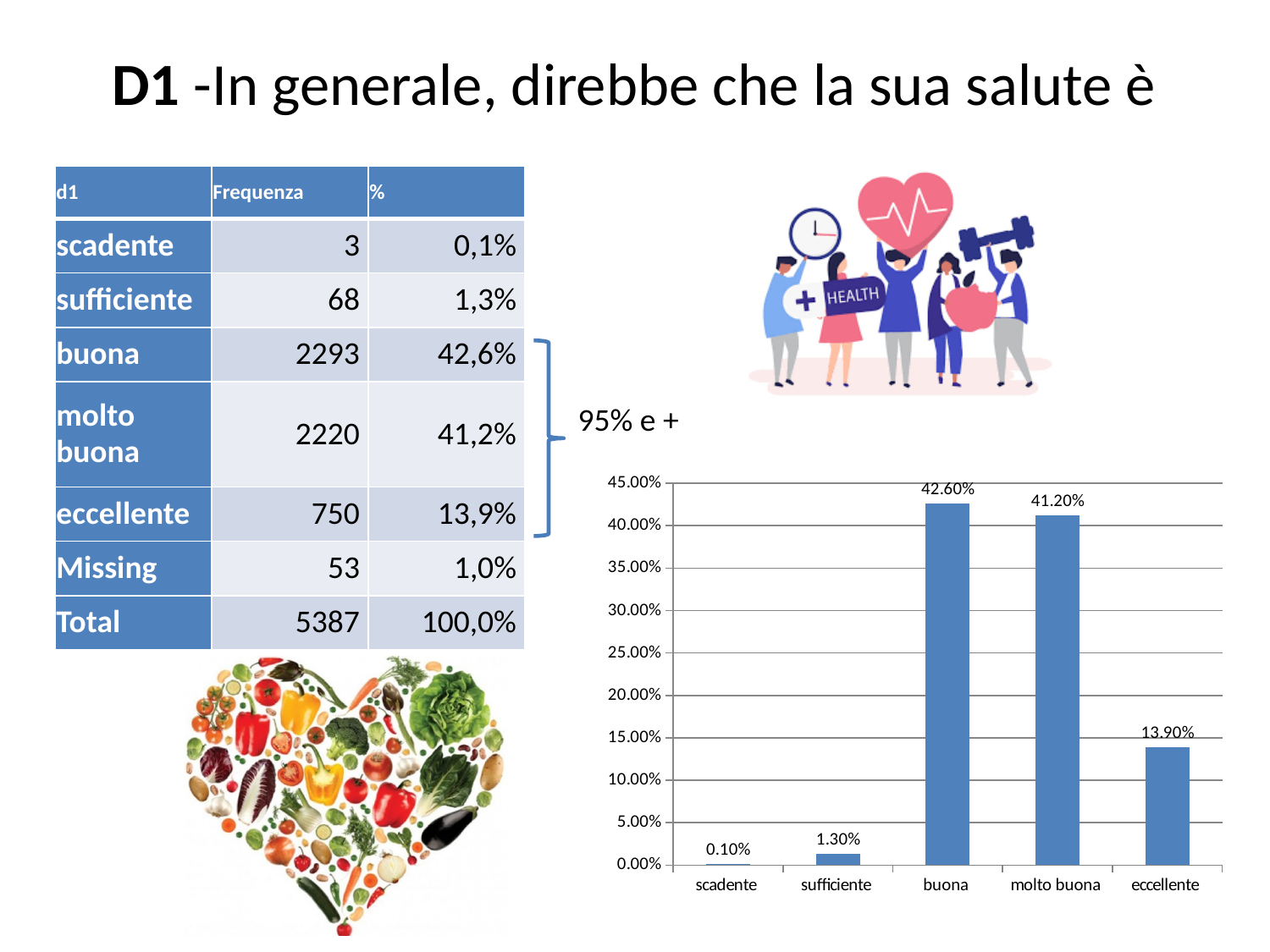
Which is larger in the chart, the value for eccellente or the value for sufficiente? eccellente What is the value for buona in the chart? 42.60% What is the value for sufficiente in the chart? 1.30% What is the value for molto buona in the chart? 41.20% What is the value for scadente in the chart? 0.10% Which category has the lowest value in the chart? scadente Is the value for eccellente in the chart greater or less than 15.00%? less Which category has the highest value in the chart? buona How many categories are shown on the x axis of the chart? 5 What type of chart is shown on the slide? bar chart What is the value for eccellente in the chart? 13.90% What is the difference between the values for buona and molto buona in the chart? 1.40%